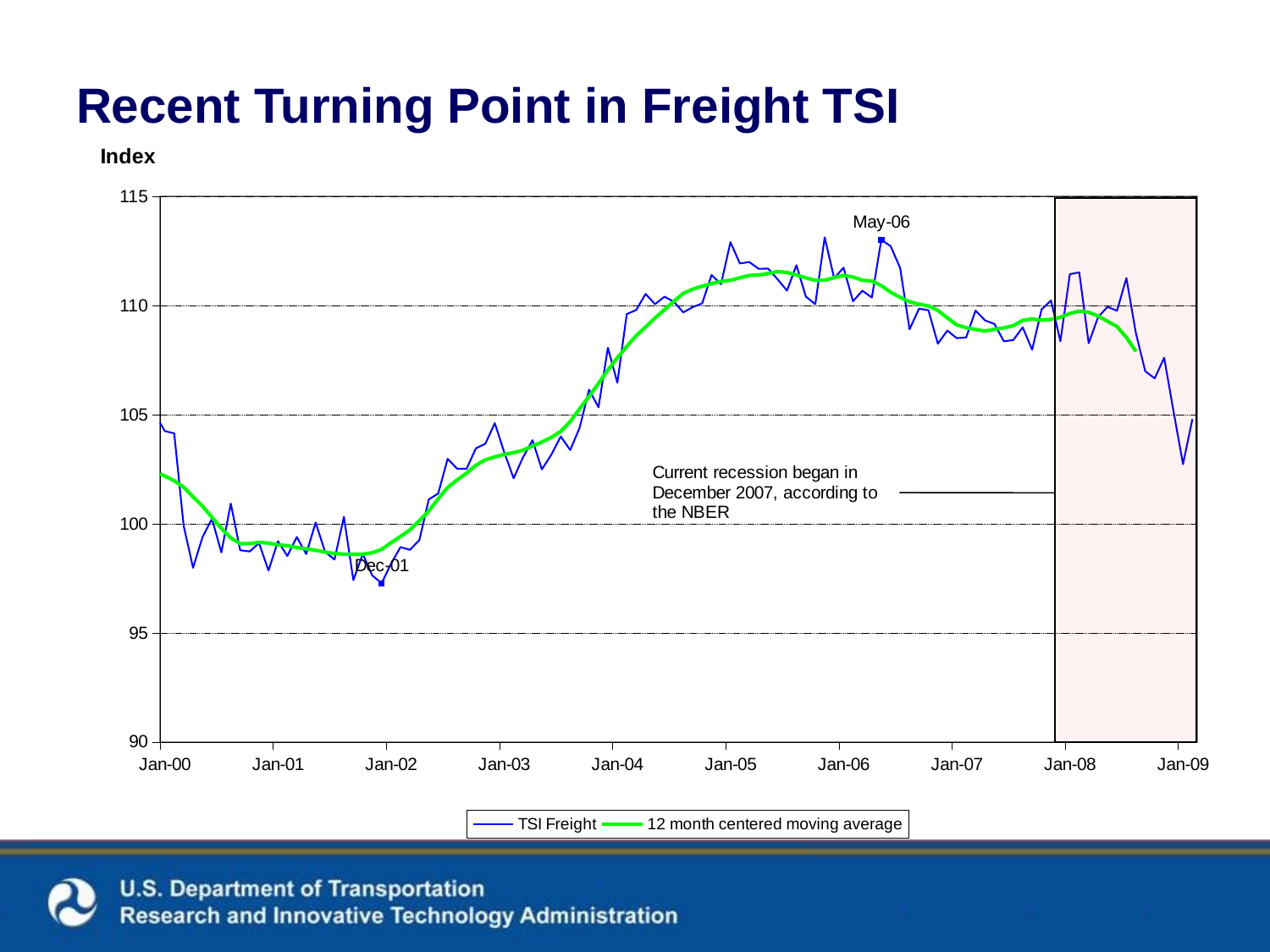
Is the TSI Freight value at Dec-01 greater or less than 100? less How many series does the legend list? 2 Does the 12 month centered moving average rise or fall between Jan-02 and Jan-05? Rise What are the two series named in the legend? TSI Freight and 12 month centered moving average Which labeled month marks the trough of the TSI Freight series? Dec-01 Is the TSI Freight value at May-06 greater or less than 110? greater Is the TSI Freight value at Jan-05 greater or less than 110? greater What kind of chart is shown on the slide? Line chart Which is higher, the TSI Freight value at May-06 or at Dec-01? May-06 Which labeled month marks the peak of the TSI Freight series? May-06 What is the title of the chart on the slide? Recent Turning Point in Freight TSI